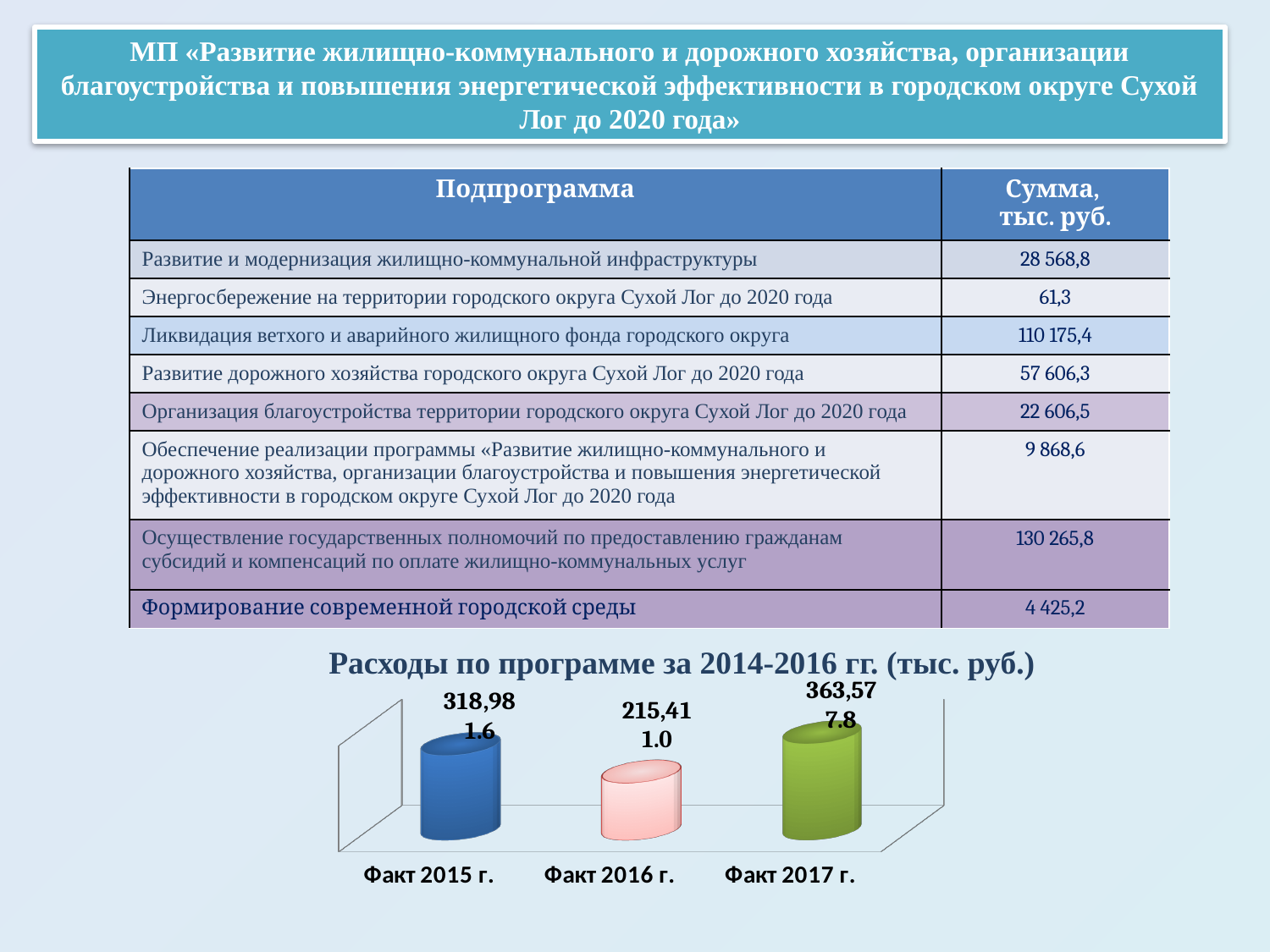
What is the value shown for Факт 2016 г. in the chart? 215,411.0 What is the value shown for Факт 2015 г. in the chart? 318,981.6 What is the title of the chart on the slide? Расходы по программе за 2014-2016 гг. (тыс. руб.) What is the value shown for Факт 2017 г. in the chart? 363,577.8 What is the difference between the values for Факт 2017 г. and Факт 2015 г.? 44,596.2 What kind of chart is shown under the title «Расходы по программе за 2014-2016 гг. (тыс. руб.)»? Bar chart What colour is the bar for Факт 2017 г. in the chart? Green How many categories are plotted in the chart? 3 Which is larger in the chart: the value for Факт 2015 г. or the value for Факт 2016 г.? Факт 2015 г. Which category has the highest value in the chart? Факт 2017 г. Which category has the lowest value in the chart? Факт 2016 г. What is the difference between the values for Факт 2015 г. and Факт 2016 г.? 103,570.6